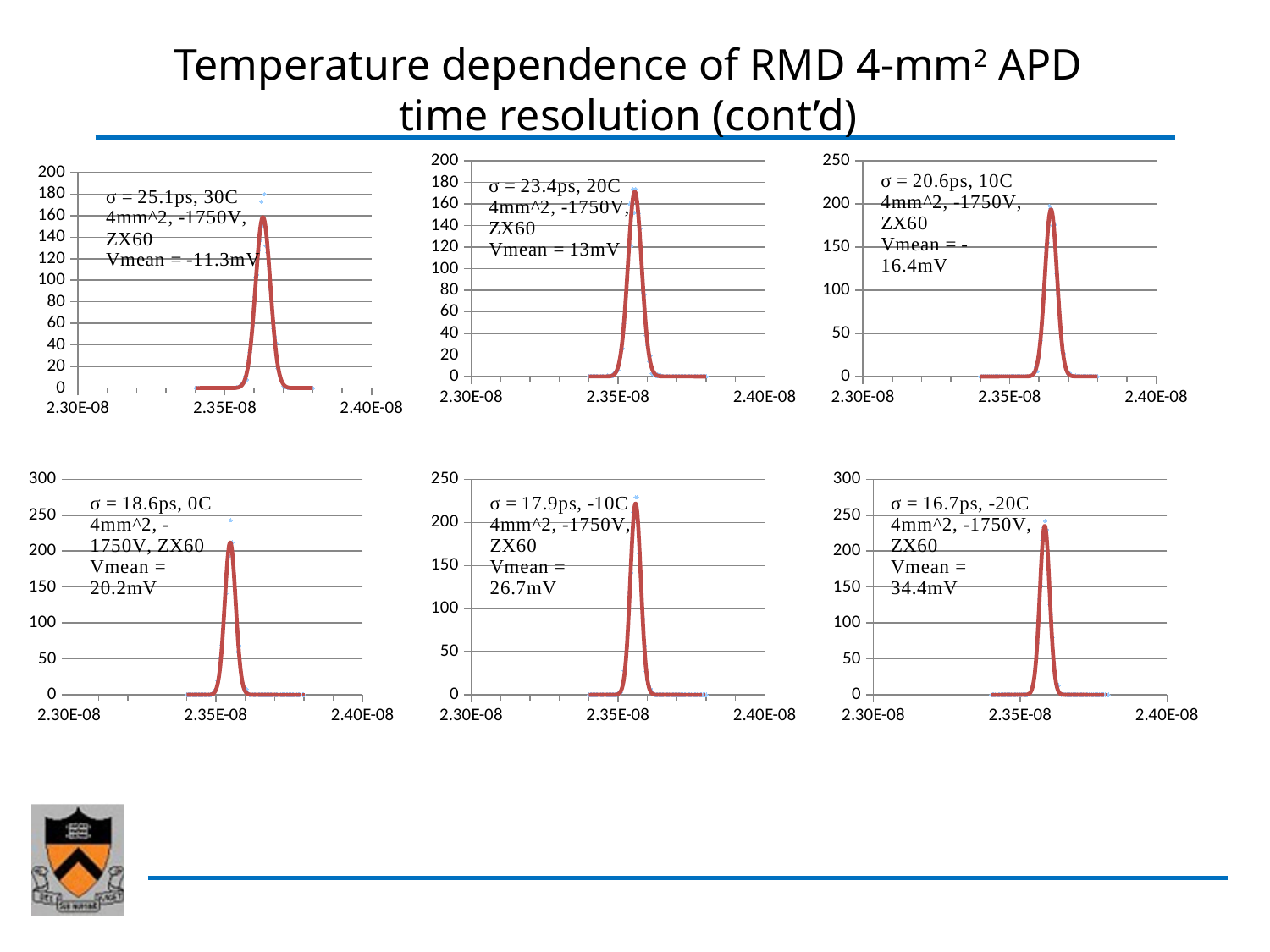
In the bottom-right chart (σ = 16.7ps, -20C), is the peak value greater or less than 200? greater What kind of chart is the top-left chart (σ = 25.1ps, 30C)? line chart In the bottom-left chart (σ = 18.6ps, 0C), is the peak value greater or less than 150? greater In the bottom-right chart (σ = 16.7ps, -20C), is the peak value greater or less than 300? less How many charts are shown on the slide? 6 What σ value is annotated on the top-left chart? 25.1ps